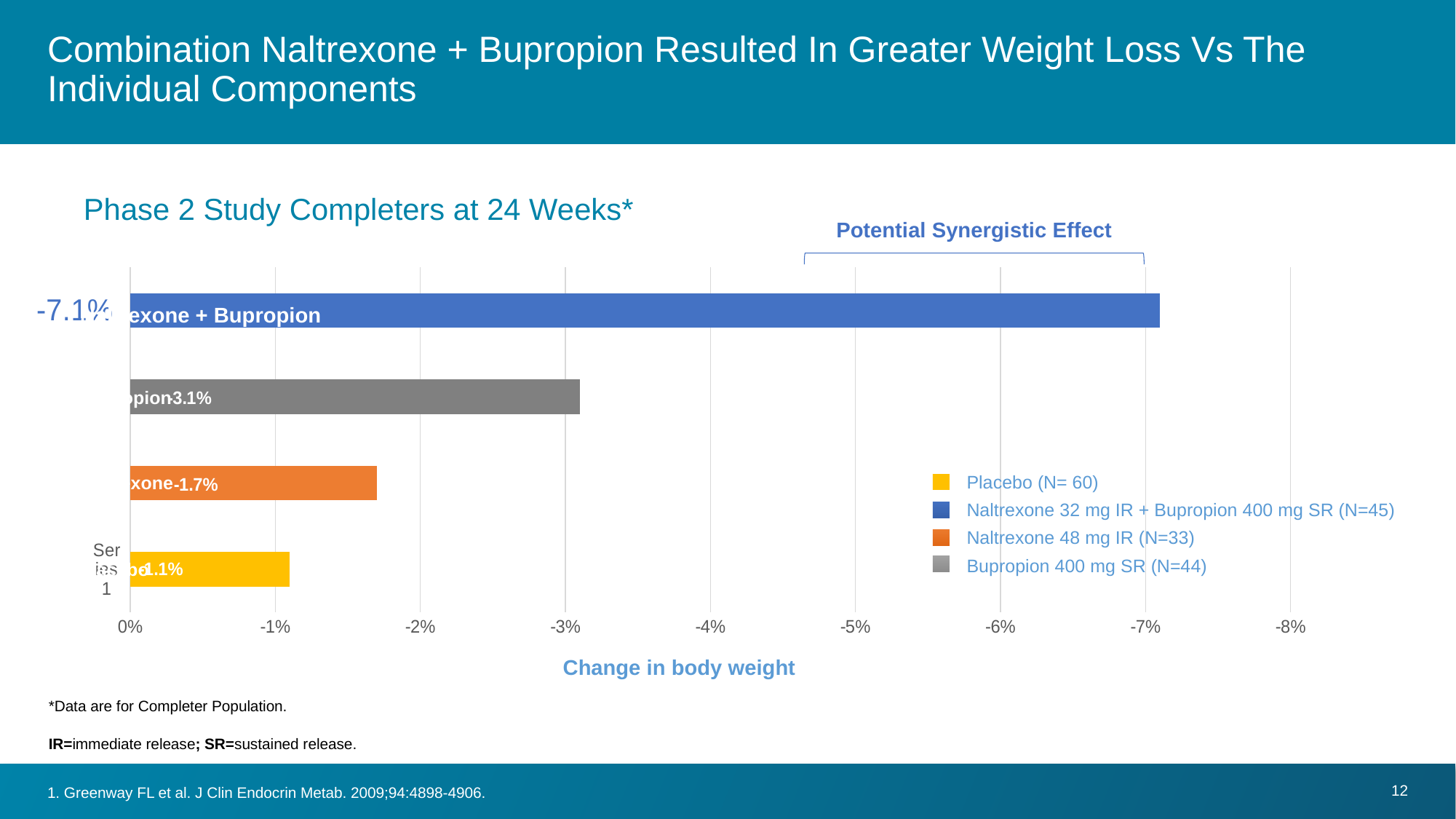
How many entries does the legend list? 4 What is the title of the x axis of the chart? Change in body weight What type of chart is shown on the slide? Bar chart Which treatment group shows the smallest change in body weight? Placebo Which bar is longer: Naltrexone 48 mg IR or Bupropion 400 mg SR? Bupropion 400 mg SR What is the change in body weight shown for the Placebo bar? -1.1% What is the change in body weight shown for the Bupropion 400 mg SR bar? -3.1% What is the change in body weight shown for the Naltrexone 48 mg IR bar? -1.7% Which treatment group shows the largest weight loss (longest bar)? Naltrexone + Bupropion What is the change in body weight shown for the Naltrexone + Bupropion combination bar? -7.1% What is the difference in percentage points between the Naltrexone + Bupropion bar (-7.1%) and the Bupropion bar (-3.1%)? 4.0 percentage points How many bars are plotted in the chart? 4